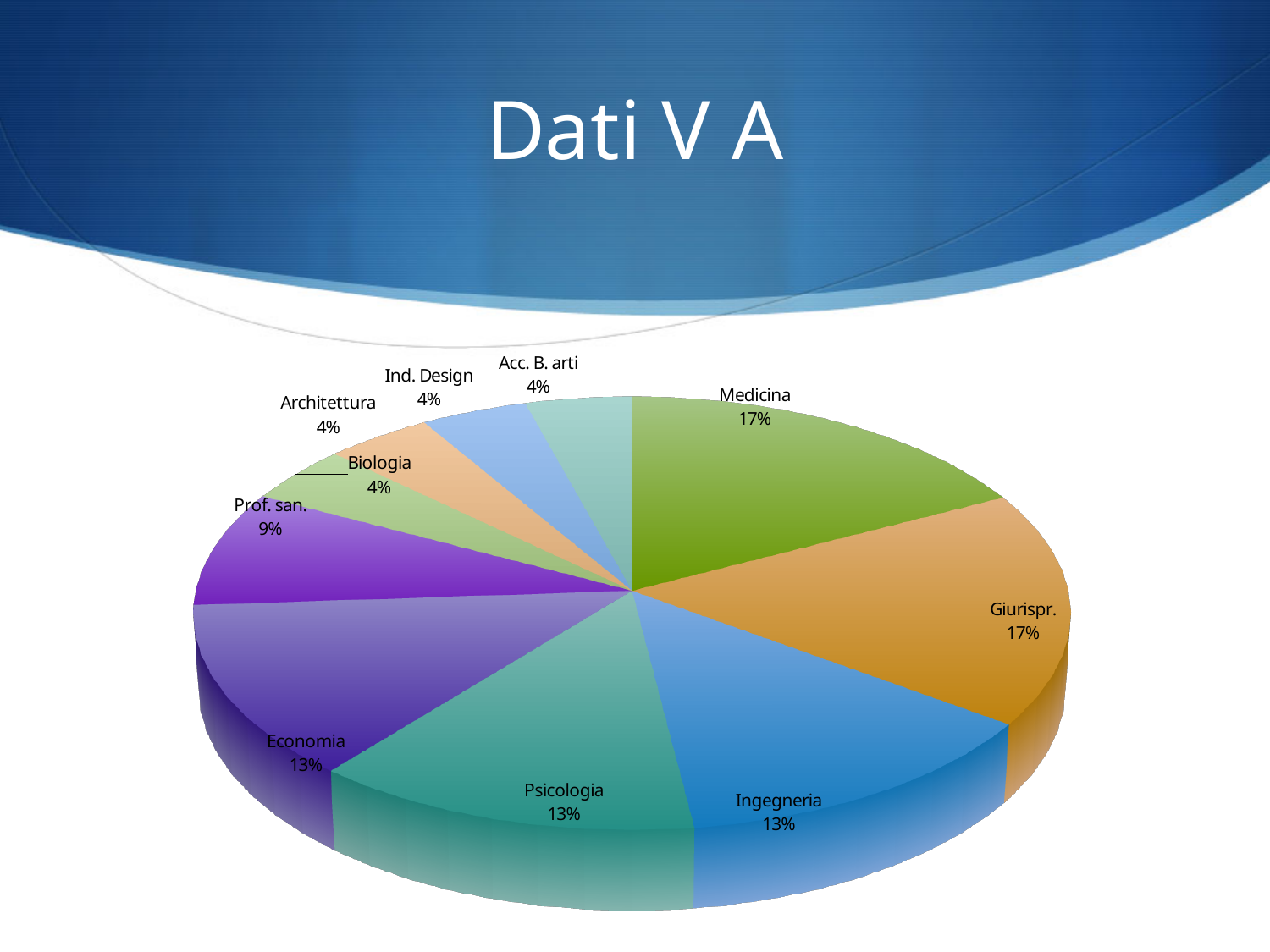
What kind of chart is shown on the slide? pie chart What is the value shown for Biologia? 4% Which is larger, the share for Economia or the share for Architettura? Economia What share of the pie does Psicologia represent? 13% What is the difference in percentage points between Medicina and Prof. san.? 8 How many slices does the pie chart have? 10 What is the value shown for Prof. san.? 9% What share of the pie does Medicina represent? 17% What is the title of the slide? Dati V A What is the difference in percentage points between Ingegneria and Ind. Design? 9 What is the value shown for Giurispr.? 17% Which is larger, the share for Giurispr. or the share for Psicologia? Giurispr.